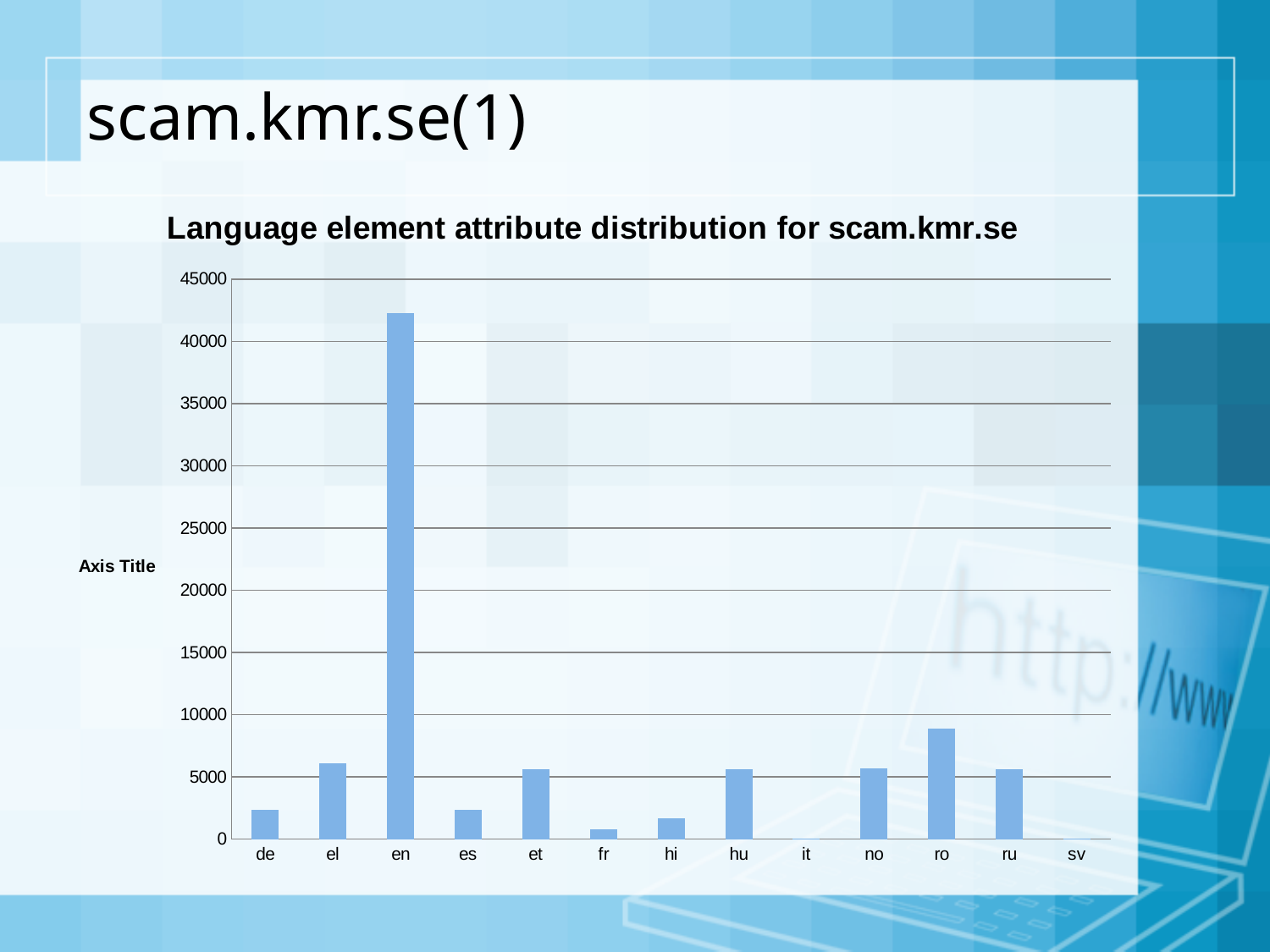
What is the title of the chart? Language element attribute distribution for scam.kmr.se Is the value for ro greater or less than 5000? greater Is the value for ro greater or less than 10000? less Which is larger, the value for ro or the value for el? ro What kind of chart is shown on the slide? bar chart Is the value for en greater or less than 40000? greater Which is larger, the value for hi or the value for fr? hi What label is shown on the vertical axis? Axis Title How many language categories are shown on the x axis? 13 Which language has the highest value? en